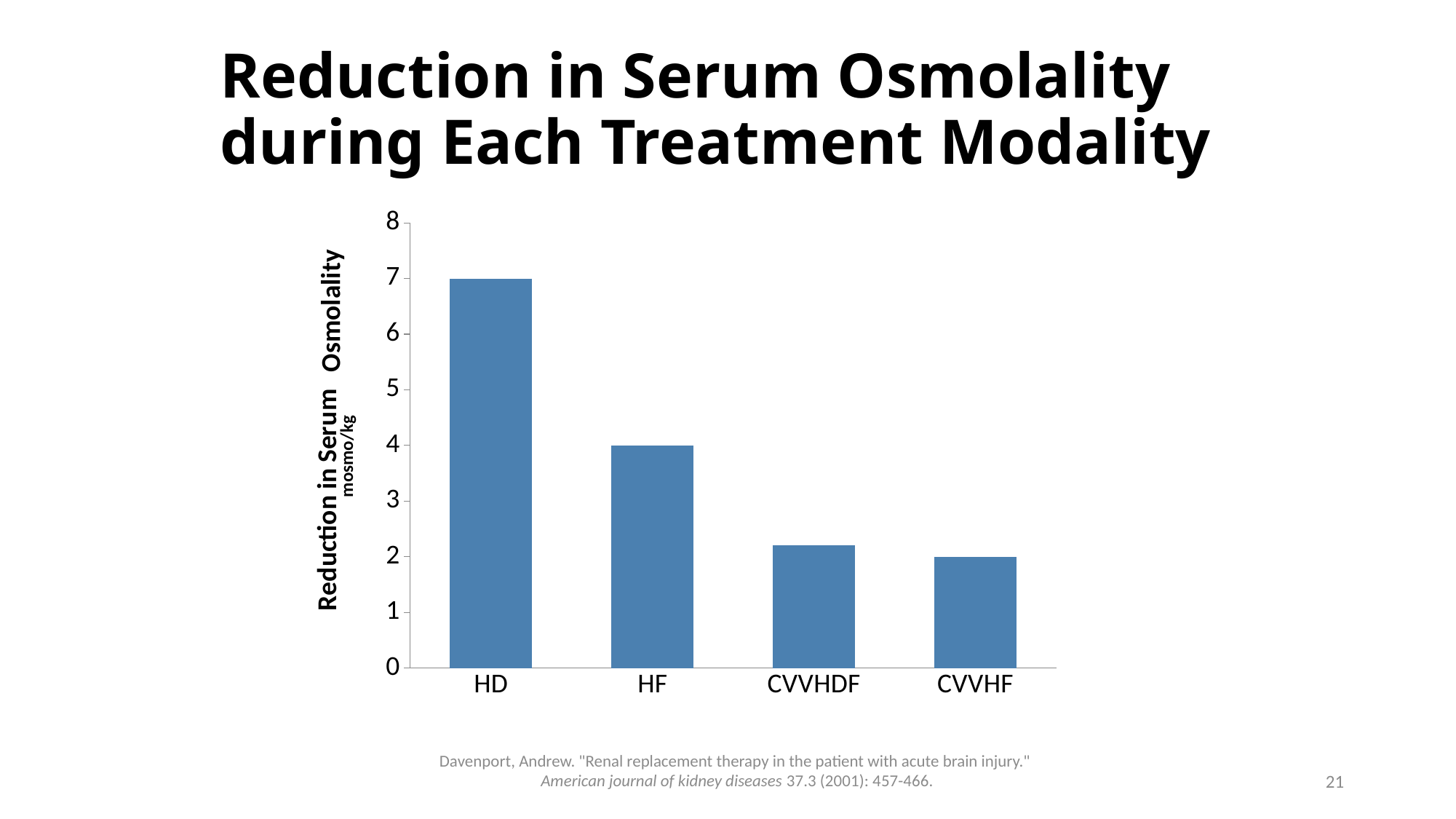
Do the values rise or fall moving from HD to CVVHF along the x axis? Fall What is the reduction in serum osmolality for CVVHF? 2 Is the value for CVVHDF greater or less than 3? less Which has a larger reduction in serum osmolality, HD or HF? HD What is the reduction in serum osmolality for HD? 7 How many treatment modalities are plotted on the chart? 4 Is the value for HF greater or less than 6? less Which treatment modality has the highest reduction in serum osmolality? HD What unit is given on the y-axis label of the chart? mosmo/kg What is the reduction in serum osmolality for HF? 4 What kind of chart is shown on the slide? Bar chart What is the difference between the reduction in serum osmolality for HD and for HF? 3